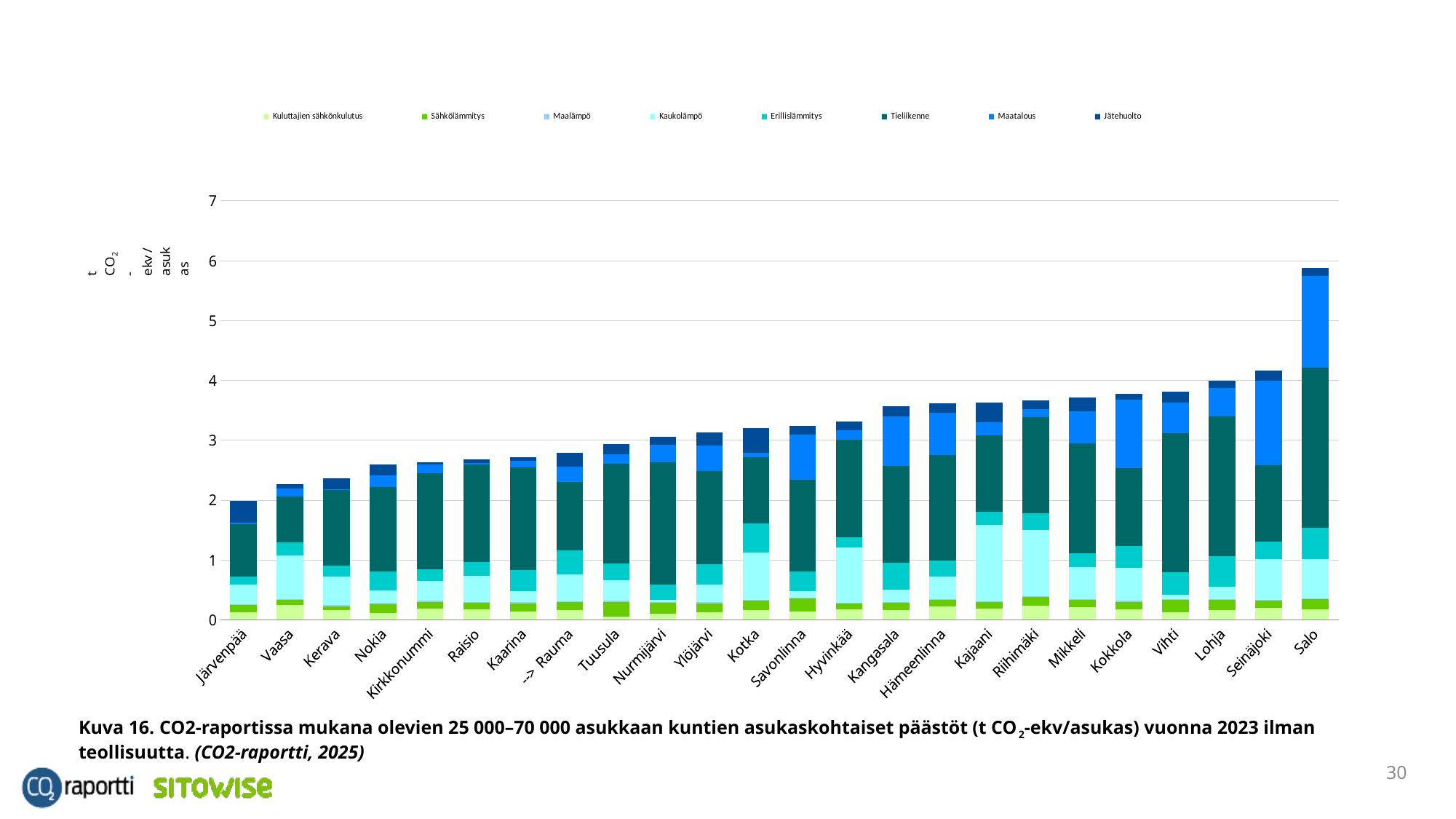
What kind of chart is shown on the slide? Stacked bar chart How many series does the legend list? 8 Which series is listed first in the legend? Kuluttajien sähkönkulutus Is the total value for Seinäjoki greater or less than 4? greater How many municipalities are shown on the x axis? 24 Is the total value for Kerava greater or less than 3? less Which municipality has the lowest total emissions per inhabitant? Järvenpää Do the total bar heights rise or fall from left to right along the x axis? rise Is the total value for Salo greater or less than 5? greater Which has the larger total, Vaasa or Kotka? Kotka Which municipality has the highest total emissions per inhabitant? Salo